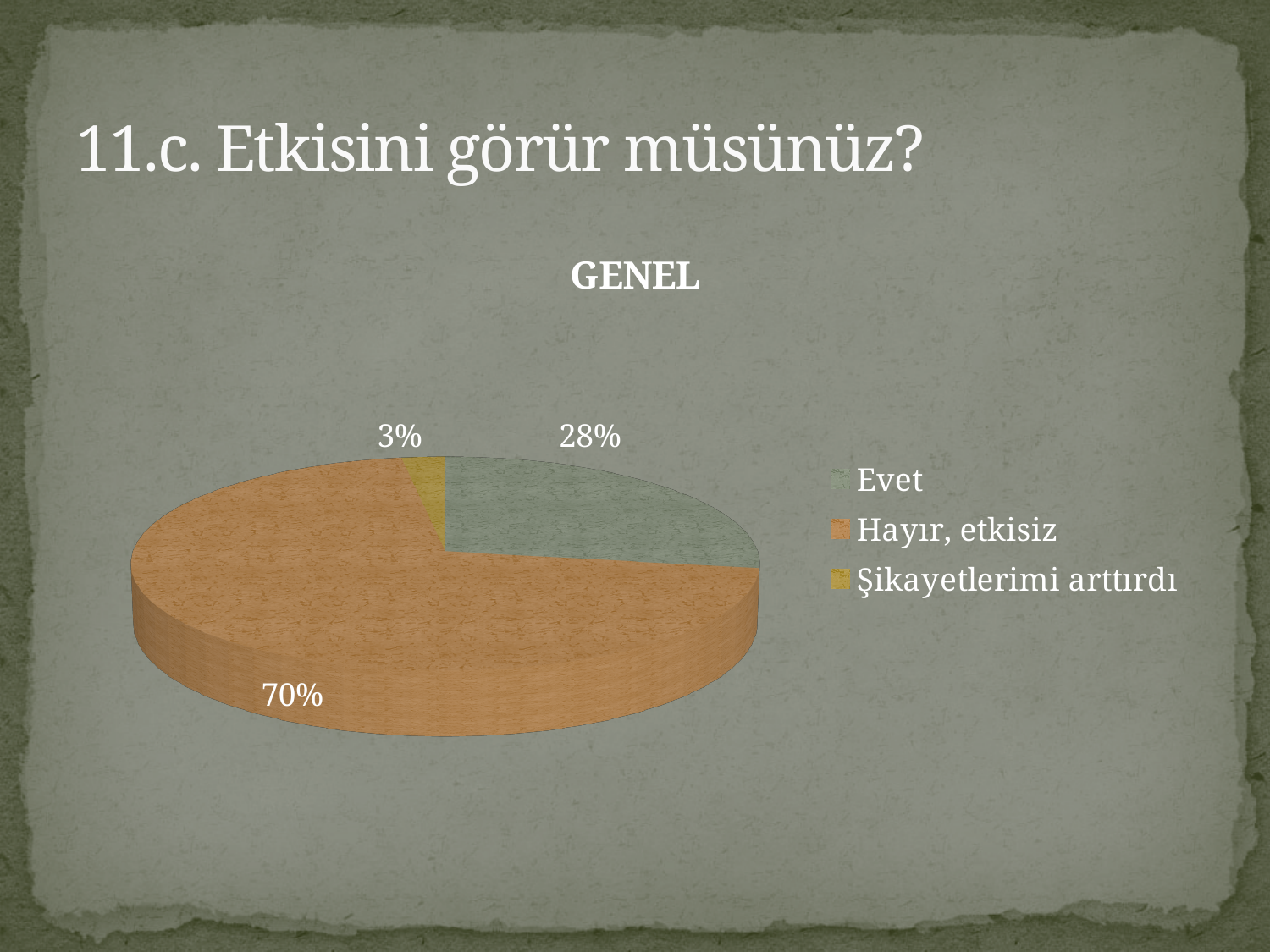
What percentage of the pie is labelled "Evet"? 28% What percentage of the pie is labelled "Hayır, etkisiz"? 70% Which is larger, the share for "Evet" or the share for "Şikayetlerimi arttırdı"? Evet What colour is the slice for "Hayır, etkisiz"? orange Which category has the largest share of the pie? Hayır, etkisiz What percentage of the pie is labelled "Şikayetlerimi arttırdı"? 3% What is the difference in percentage points between "Hayır, etkisiz" and "Evet"? 42 What kind of chart is shown on the slide? pie chart What is the title of the chart? GENEL How many categories does the legend list? 3 Which category has the smallest share of the pie? Şikayetlerimi arttırdı